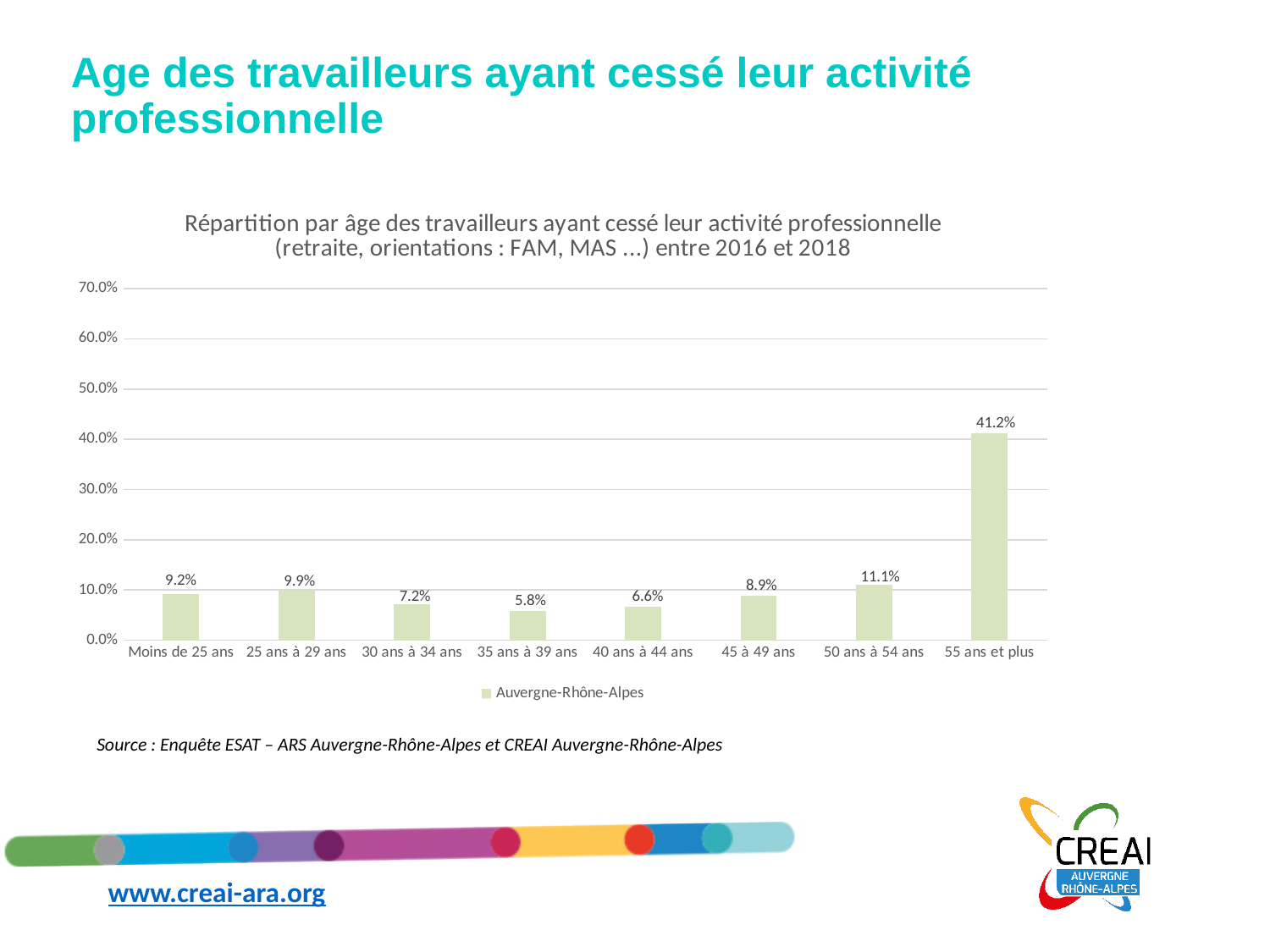
Is the value for '50 ans à 54 ans' greater or less than 10.0%? greater What series name is shown in the legend? Auvergne-Rhône-Alpes What is the value for the '35 ans à 39 ans' category? 5.8% What is the value for the '55 ans et plus' category? 41.2% What kind of chart is shown on the slide? Bar chart Which age category has the lowest value? 35 ans à 39 ans How many age categories are shown on the x axis? 8 What is the value for the 'Moins de 25 ans' category? 9.2% What is the difference between the values for '55 ans et plus' and '50 ans à 54 ans'? 30.1% How many series does the legend list? 1 Which age category has the highest value? 55 ans et plus Which is larger, the value for '25 ans à 29 ans' or the value for '45 à 49 ans'? 25 ans à 29 ans